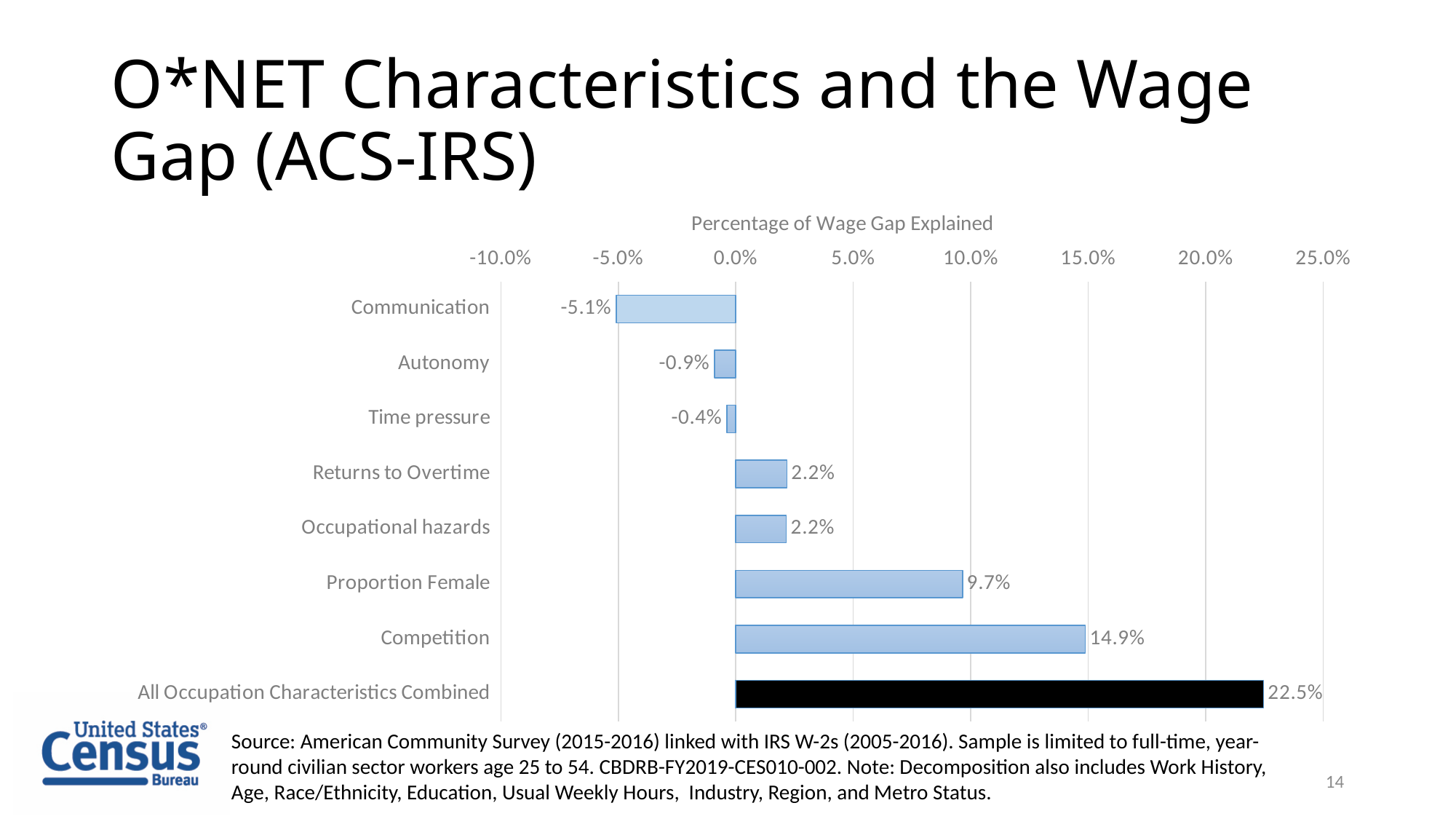
What is the value for Proportion Female? 9.7% What is the title of the chart's horizontal axis? Percentage of Wage Gap Explained Which category has the lowest value? Communication How many categories are shown in the chart? 8 What is the value for Communication? -5.1% Which category has the highest value? All Occupation Characteristics Combined What is the difference between the values for Competition and Proportion Female? 5.2% What is the value for Competition? 14.9% What is the value for All Occupation Characteristics Combined? 22.5% What kind of chart is shown on the slide? Bar chart Which is larger, the value for Autonomy or the value for Time pressure? Time pressure Is the value for Competition greater or less than 10.0%? greater